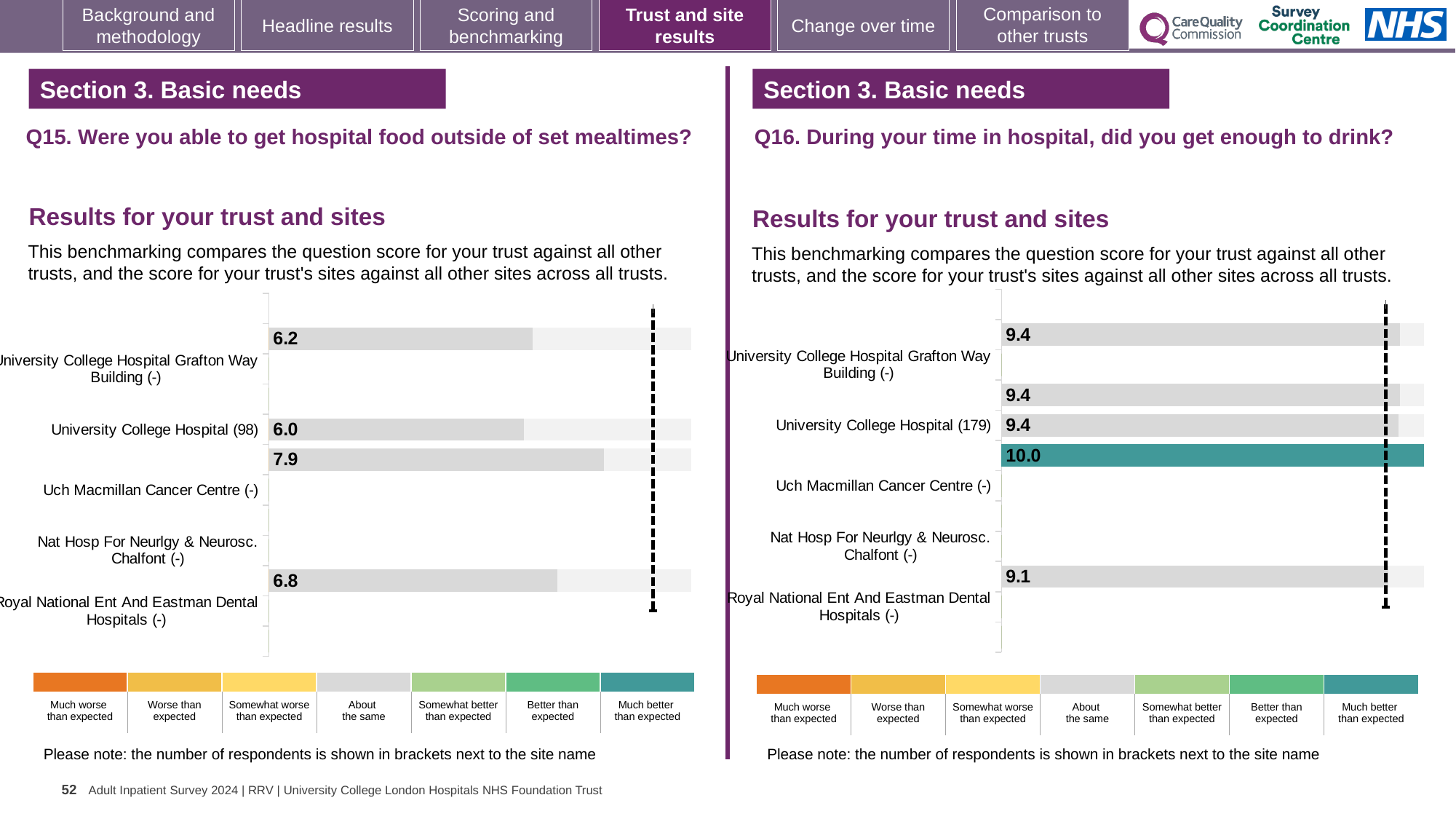
In the Q15 chart, what is the highest score shown on any bar? 7.9 In the Q16 chart, what is the difference between the highest bar score (10.0) and the lowest bar score (9.1)? 0.9 What kind of chart is used on the left (Q15) side of the slide? bar chart Which is larger: the highest score in the Q15 chart or the highest score in the Q16 chart? Q16 chart (10.0) In the Q15 chart, what is the score for University College Hospital (98)? 6.0 In the Q16 chart, what is the lowest score shown on any bar? 9.1 How many bars with data labels are shown in the Q15 chart? 4 How many rating categories does the colour legend below each chart list? 7 In the Q15 chart, what is the difference between the highest bar score (7.9) and the lowest bar score (6.0)? 1.9 In the Q16 chart, what is the score for University College Hospital (179)? 9.4 In the Q16 chart, what is the highest score shown on any bar? 10.0 In the Q15 chart, what is the lowest score shown on any bar? 6.0